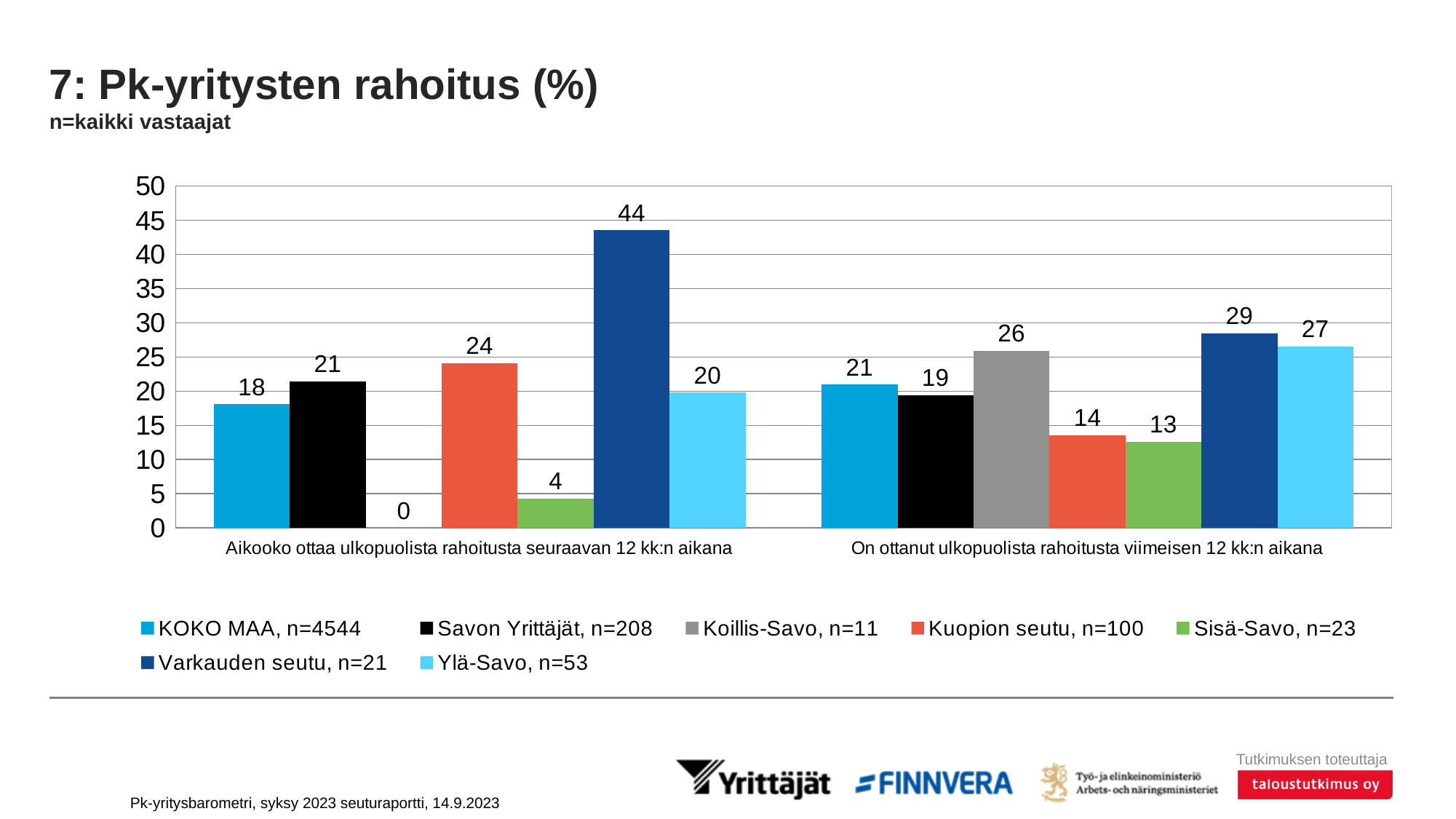
Is the value for Ylä-Savo in the category "On ottanut ulkopuolista rahoitusta viimeisen 12 kk:n aikana" greater or less than 25? greater Which series has the highest value in the category "On ottanut ulkopuolista rahoitusta viimeisen 12 kk:n aikana"? Varkauden seutu, n=21 What is the title of the chart? 7: Pk-yritysten rahoitus (%) What is the difference between the Varkauden seutu value and the Ylä-Savo value in the category "Aikooko ottaa ulkopuolista rahoitusta seuraavan 12 kk:n aikana"? 24 What is the value for KOKO MAA in the category "Aikooko ottaa ulkopuolista rahoitusta seuraavan 12 kk:n aikana"? 18 How many categories are shown on the x axis? 2 What is the value for Koillis-Savo in the category "On ottanut ulkopuolista rahoitusta viimeisen 12 kk:n aikana"? 26 What is the value for Varkauden seutu in the category "Aikooko ottaa ulkopuolista rahoitusta seuraavan 12 kk:n aikana"? 44 Which series has the lowest value in the category "Aikooko ottaa ulkopuolista rahoitusta seuraavan 12 kk:n aikana"? Koillis-Savo, n=11 What kind of chart is shown on the slide? bar chart How many series does the legend list? 7 In the category "On ottanut ulkopuolista rahoitusta viimeisen 12 kk:n aikana", which is larger: the value for Kuopion seutu or the value for Sisä-Savo? Kuopion seutu